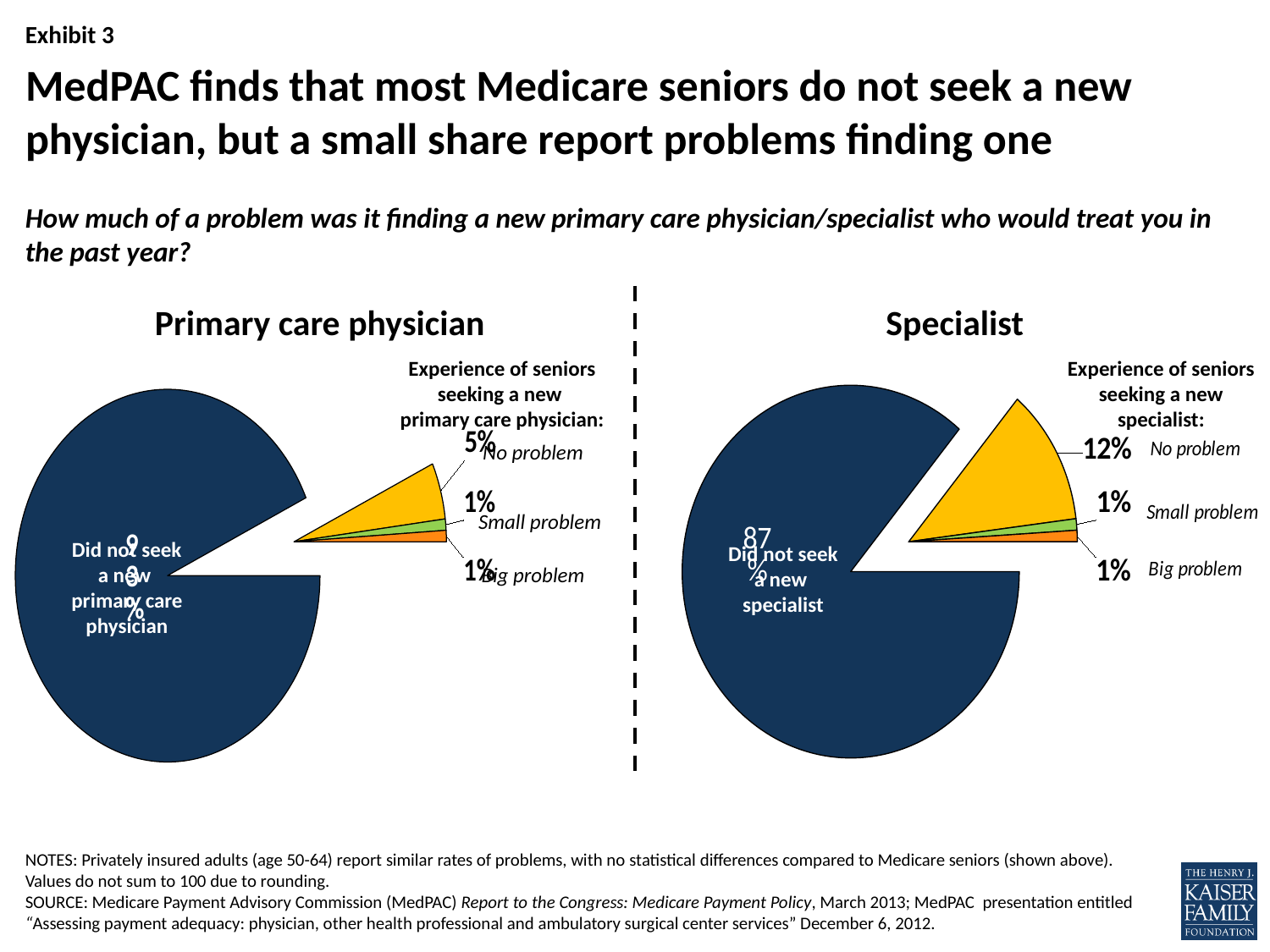
What is the title of the pie chart on the left side of the slide? Primary care physician In the Specialist pie chart, what share of seniors reported a 'Big problem'? 1% In the Specialist pie chart, what colour is the 'No problem' slice? Yellow What kind of chart is used for the Primary care physician data? Pie chart Which chart shows a larger 'No problem' share, the Primary care physician chart or the Specialist chart? Specialist What is the difference between the 'No problem' share in the Specialist chart and the 'No problem' share in the Primary care physician chart? 7 percentage points How many slices does the Specialist pie chart have? 4 In the Specialist pie chart, which of the three 'experience of seniors seeking a new specialist' categories has the largest share? No problem In the Primary care physician pie chart, which category has the largest slice? Did not seek a new primary care physician In the Primary care physician pie chart, what share of seniors reported 'No problem' finding a new primary care physician? 5% In the Specialist pie chart, what share of seniors reported 'No problem' finding a new specialist? 12% In the Primary care physician pie chart, what share of seniors reported a 'Small problem'? 1%